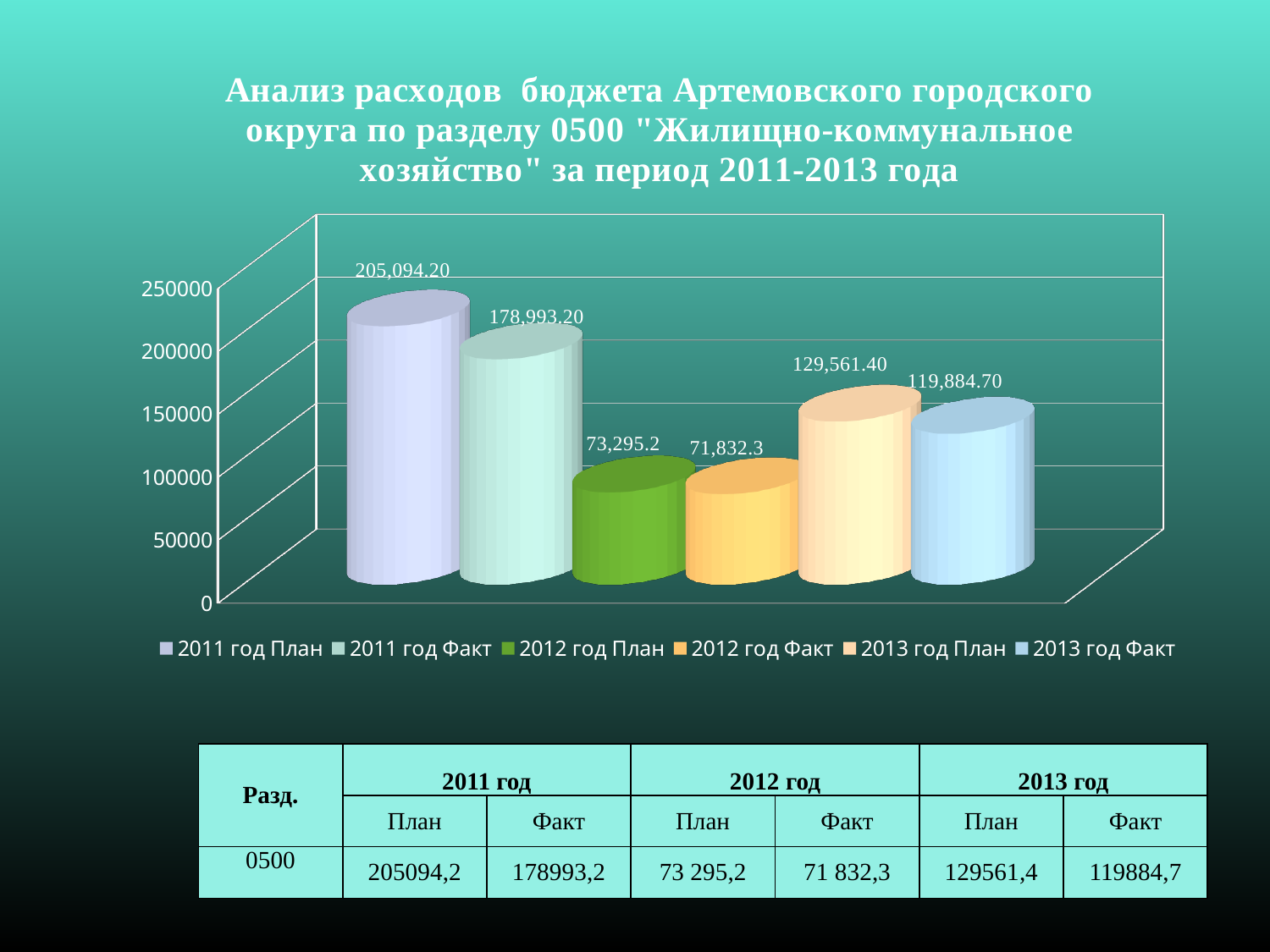
What is the value shown for 2011 год Факт? 178,993.20 Which is larger, the value for 2013 год План or the value for 2011 год Факт? 2011 год Факт What is the value shown for 2012 год План? 73,295.2 Which series has the lowest value in the chart? 2012 год Факт What is the difference between the 2011 год План and 2011 год Факт values? 26,101.00 Which series has the highest value in the chart? 2011 год План What kind of chart is shown on the slide? bar chart What is the value shown for 2013 год Факт? 119,884.70 Is the value for 2012 год План greater or less than 100000? less What is the difference between the 2013 год План and 2013 год Факт values? 9,676.70 What is the value shown for 2011 год План? 205,094.20 How many series does the legend list? 6